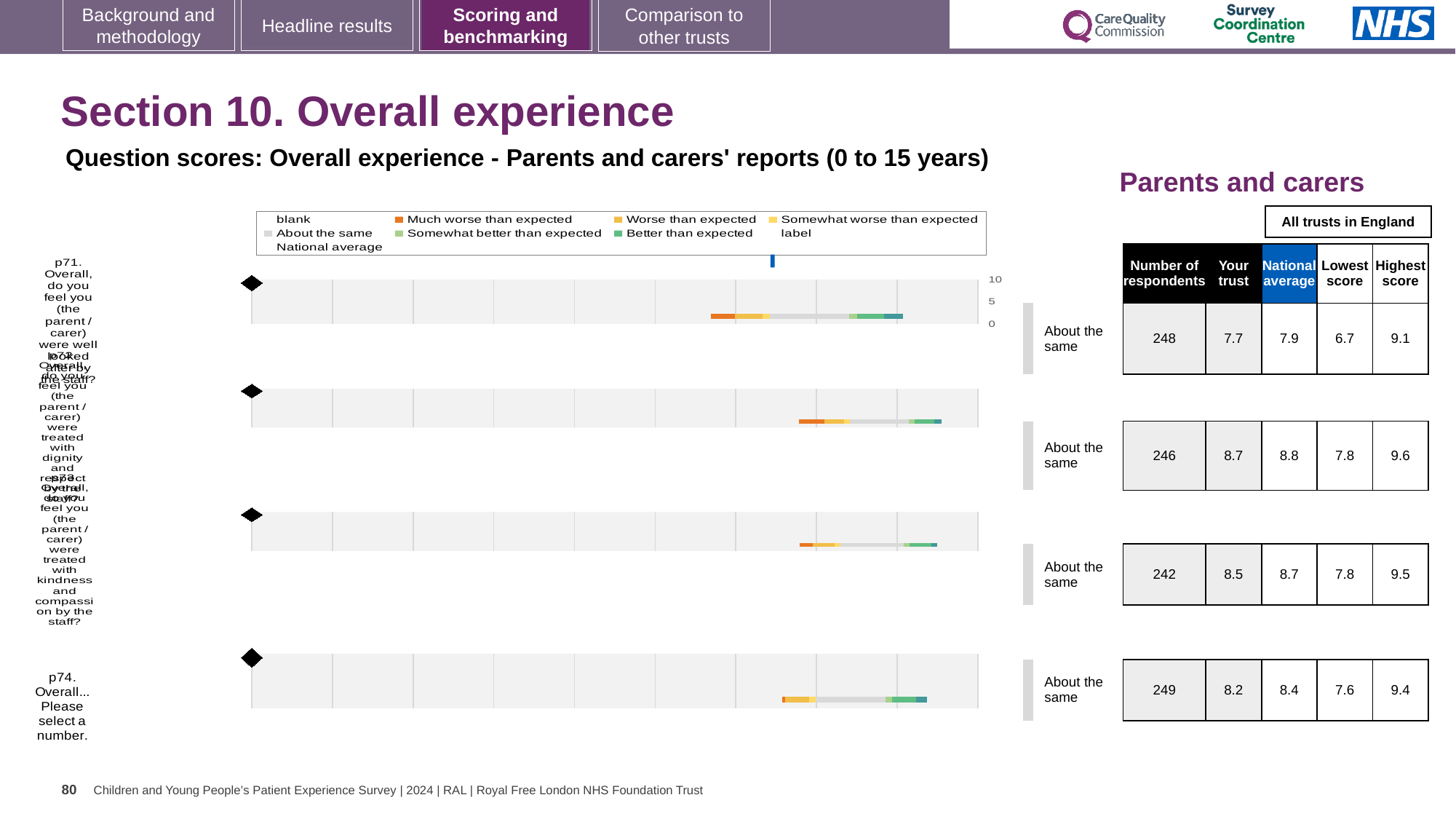
How many respondents answered question p74? 249 What is the 'Your trust' score for question p71? 7.7 Which question has the lowest 'Your trust' score? p71 What is the national average for question p72? 8.8 How many survey questions (rows) are plotted in the chart? 4 What is the difference between the highest score (9.1) and the lowest score (6.7) for question p71? 2.4 What benchmark category is shown for every question in the chart? About the same What colour in the legend represents 'Much worse than expected'? orange What is the highest score among all trusts in England for question p73? 9.5 For question p73, which is larger: the 'Your trust' score or the national average? National average What kind of chart is shown on the slide? bar chart Which question has the highest 'Your trust' score? p72